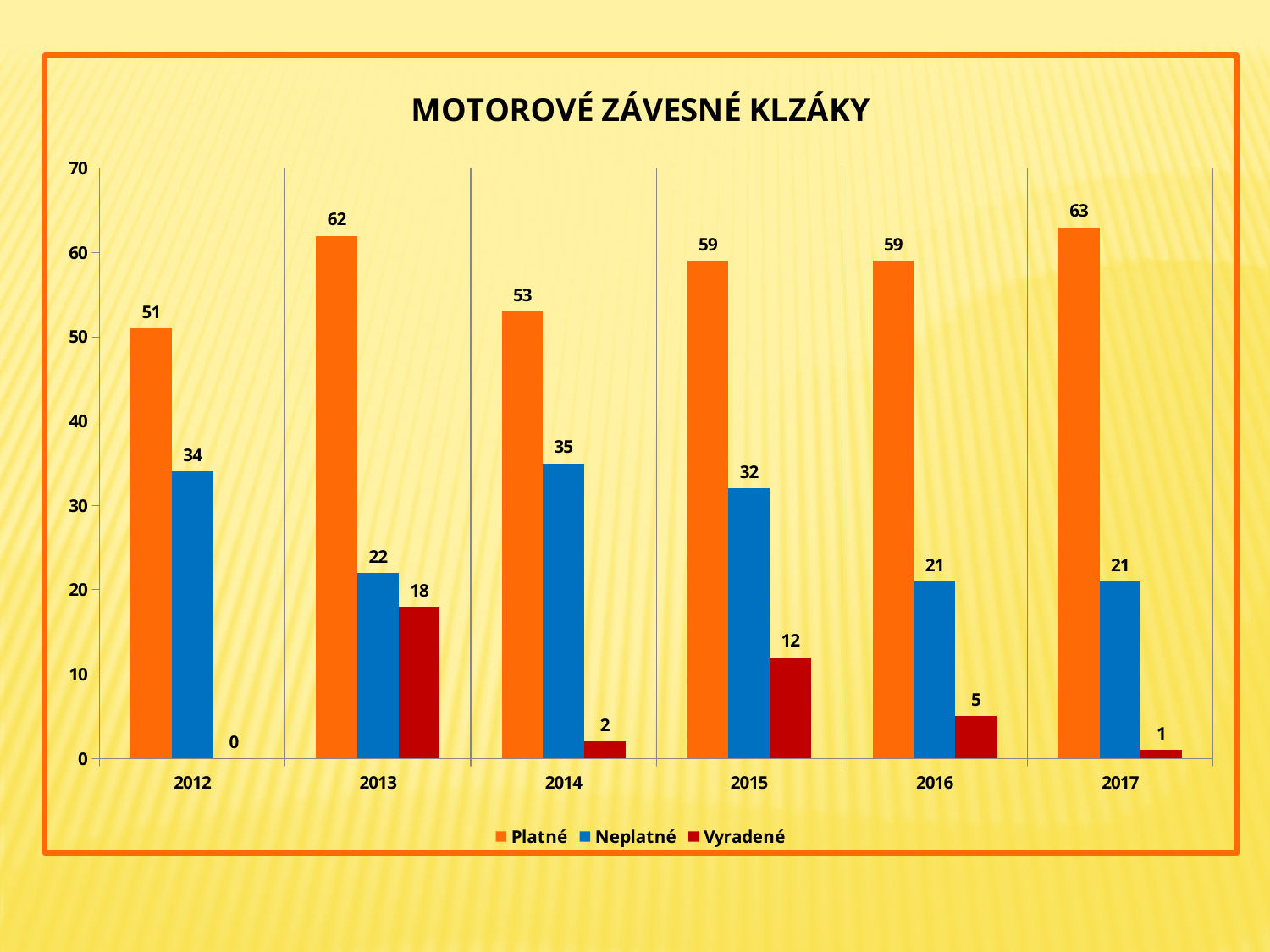
What is the value of Vyradené in 2012? 0 What is the difference between Platné and Neplatné in 2012? 17 How many series does the legend list? 3 What is the title of the chart? MOTOROVÉ ZÁVESNÉ KLZÁKY How many years are shown on the x axis? 6 In which year is Neplatné lowest? 2016 and 2017 What is the value of Neplatné in 2014? 35 Which is larger, Vyradené in 2013 or Vyradené in 2016? Vyradené in 2013 What is the value of Vyradené in 2015? 12 What is the value of Platné in 2013? 62 In which year is Platné highest? 2017 What kind of chart is this? bar chart